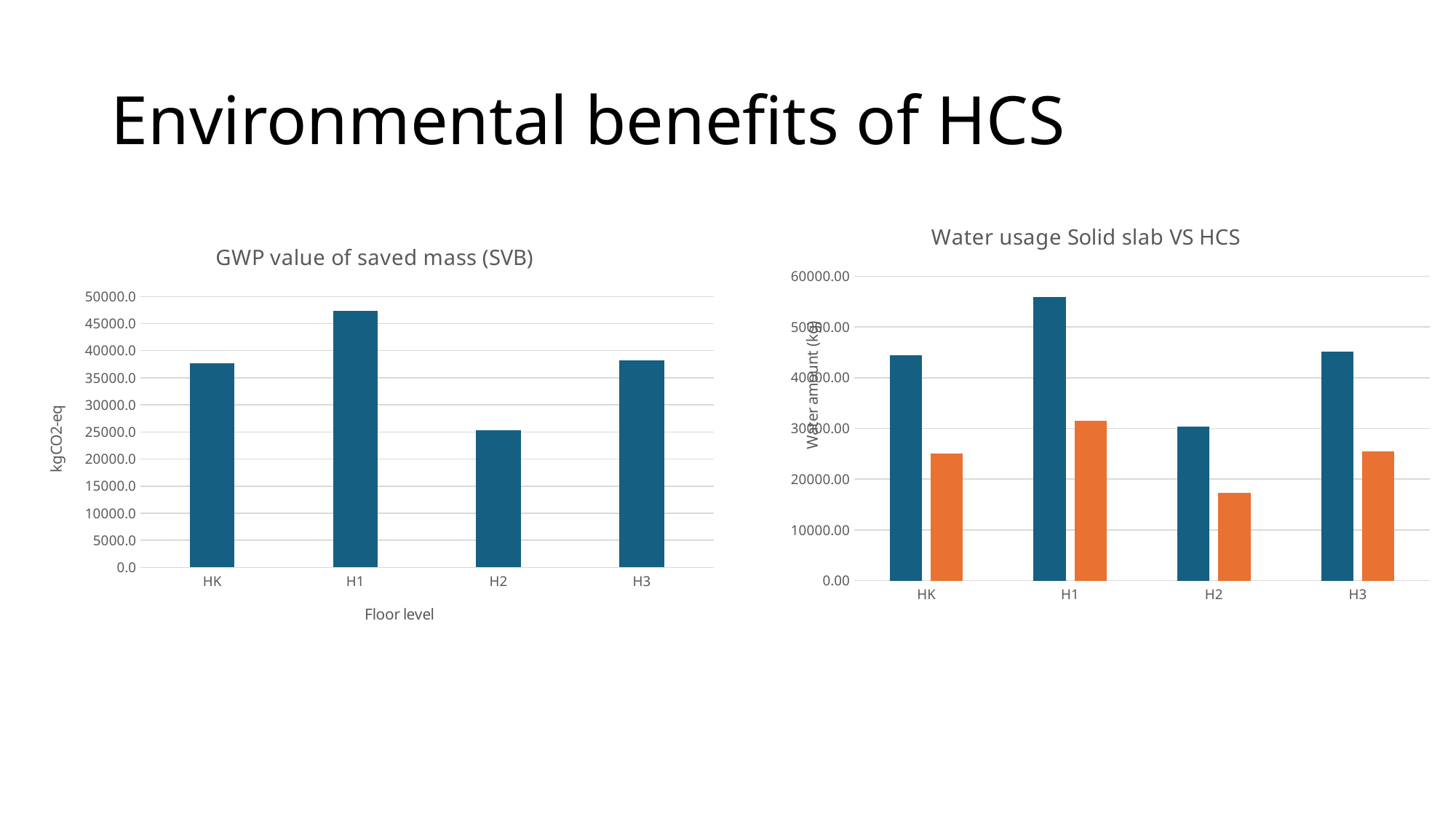
In the 'GWP value of saved mass (SVB)' chart, how many floor levels are shown on the x axis? 4 In the 'GWP value of saved mass (SVB)' chart, which floor level has the lowest value? H2 In the 'Water usage Solid slab VS HCS' chart, for floor level HK, is the blue bar or the orange bar larger? blue bar In the 'GWP value of saved mass (SVB)' chart, is the value for H2 greater or less than 30000.0? less What is the y-axis label of the 'GWP value of saved mass (SVB)' chart? kgCO2-eq In the 'GWP value of saved mass (SVB)' chart, which floor level has the highest value? H1 In the 'Water usage Solid slab VS HCS' chart, is the orange bar for H2 greater or less than 20000.00? less What kind of chart is the 'GWP value of saved mass (SVB)' chart? bar chart In the 'GWP value of saved mass (SVB)' chart, is the value for H1 greater or less than 45000.0? greater In the 'Water usage Solid slab VS HCS' chart, which floor level has the shortest orange bar? H2 In the 'Water usage Solid slab VS HCS' chart, which floor level has the tallest blue bar? H1